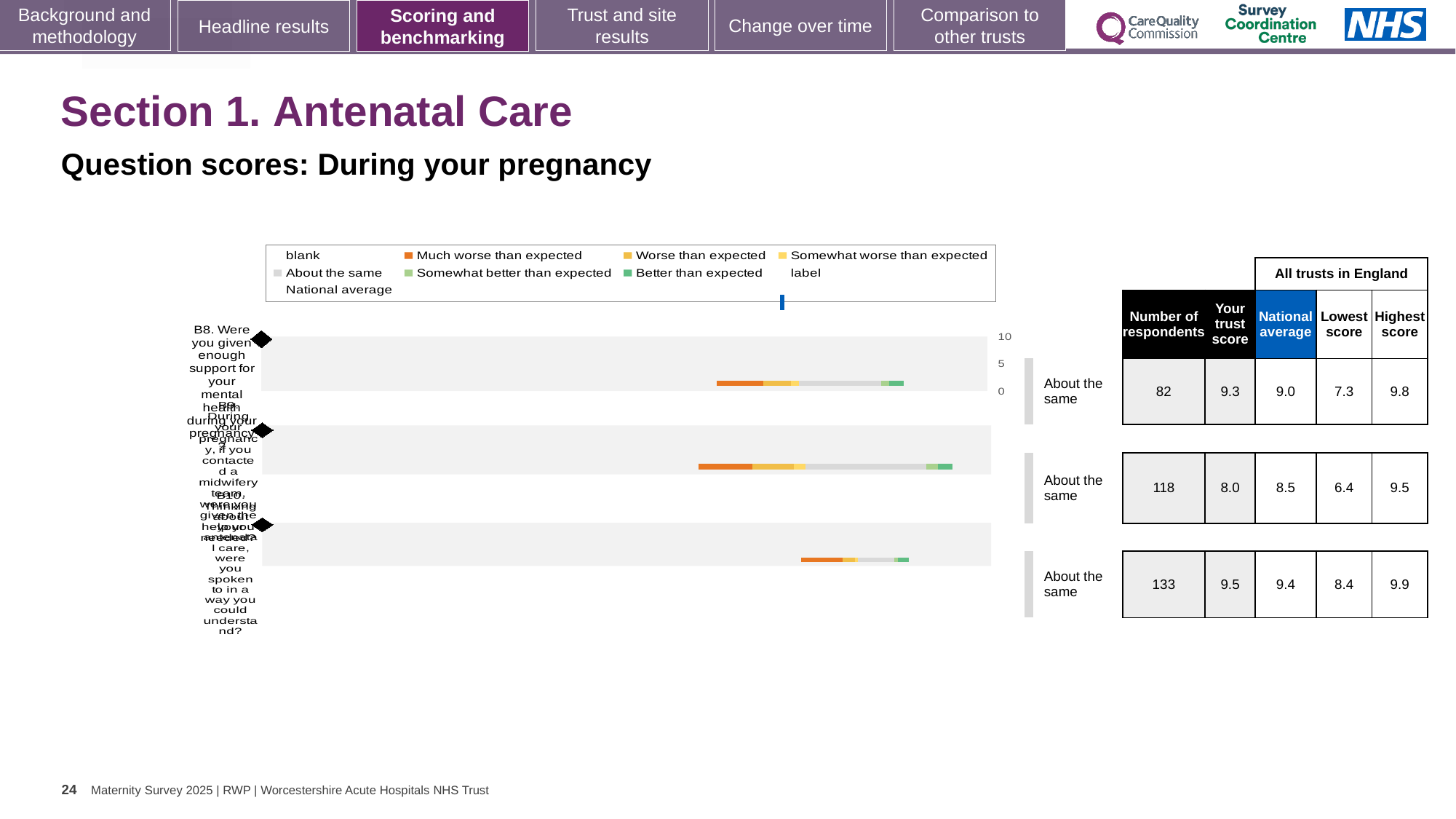
What is the national average for the top row (B8) in the table? 9.0 What is the maximum value shown on the chart's score axis? 10 Which row of the table has the highest number of respondents? the bottom row (133) In the table next to the chart, what is the number of respondents for the top row (B8, support for your mental health during pregnancy)? 82 What kind of chart is shown on the slide? bar chart What is the highest score among all trusts in England for the bottom row of the table? 9.9 How many question rows (bars) are plotted in the chart? 3 What benchmark label is shown to the right of each of the three bars? About the same For the middle row of the table, what is the difference between the highest score (9.5) and the lowest score (6.4)? 3.1 What is the lowest score among all trusts in England for the top row (B8)? 7.3 What is the 'Your trust score' value for the top row (B8) in the table? 9.3 For the middle row of the table, which is larger: the trust score or the national average? the national average (8.5)